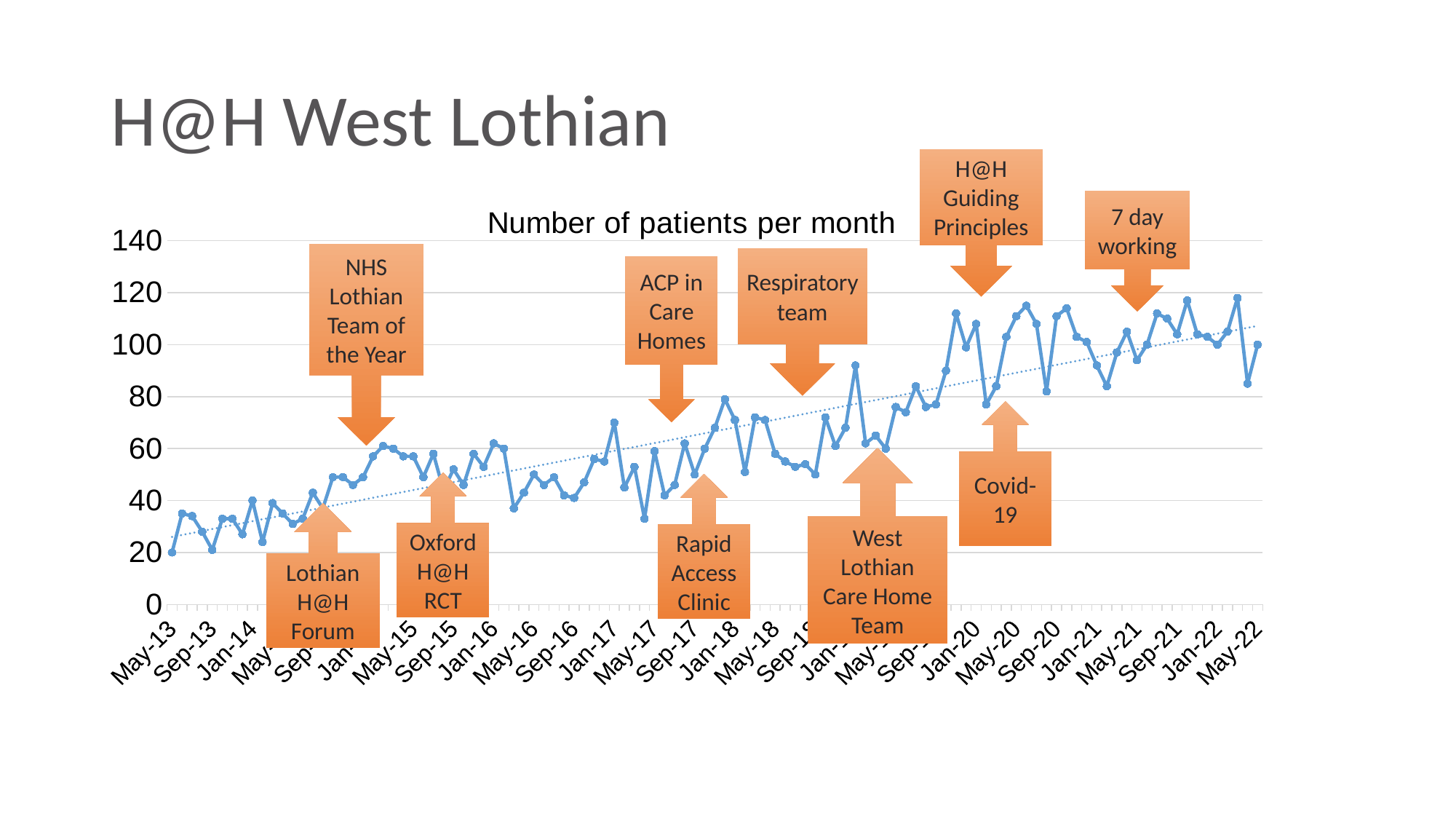
What is the first month label on the x axis? May-13 Which is larger, the value for May-13 or the value for Jan-20? Jan-20 Is the value for May-13 greater or less than 40? less What is the title of the chart? Number of patients per month What is the highest value shown on the y axis? 140 Do the values generally rise or fall from May-13 to May-22? rise Is the value for Sep-13 greater or less than 60? less What is the last month label on the x axis? May-22 What kind of chart is shown on the slide? line chart Is the value for Jan-20 greater or less than 100? greater